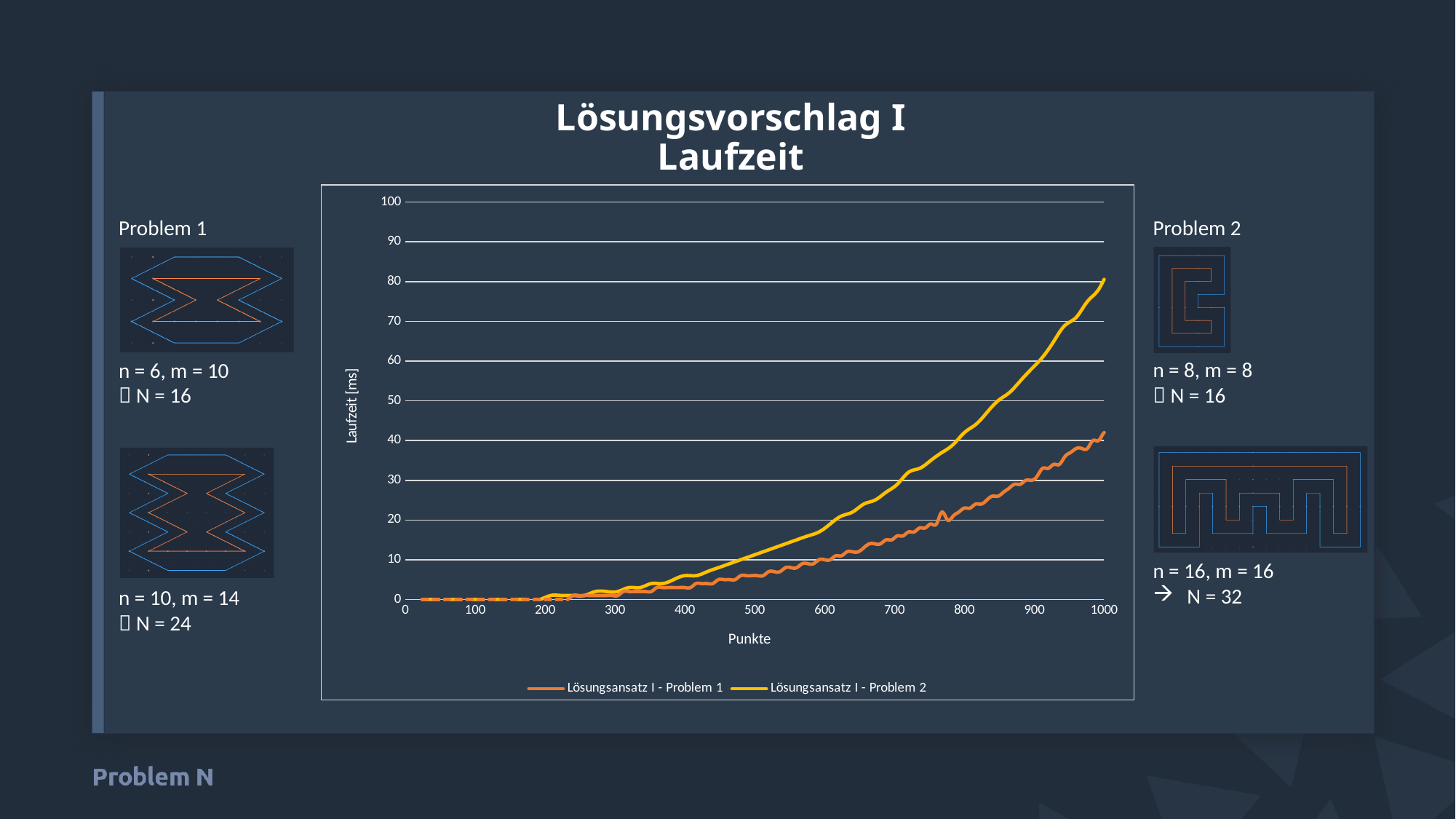
Is the runtime for Lösungsansatz I - Problem 1 at 1000 Punkte greater or less than 50 ms? less Is the runtime for Lösungsansatz I - Problem 1 at 700 Punkte greater or less than 20 ms? less What is the label of the y axis of the chart? Laufzeit [ms] Which series has the higher runtime at 1000 Punkte, Lösungsansatz I - Problem 1 or Lösungsansatz I - Problem 2? Lösungsansatz I - Problem 2 How many series does the chart legend list? 2 Do the runtime values for Lösungsansatz I - Problem 2 rise or fall as the number of Punkte increases? rise What is the label of the x axis of the chart? Punkte Is the runtime for Lösungsansatz I - Problem 2 at 1000 Punkte greater or less than 90 ms? less Do the runtime values for Lösungsansatz I - Problem 1 rise or fall along the x axis? rise What kind of chart is shown on the slide? line chart